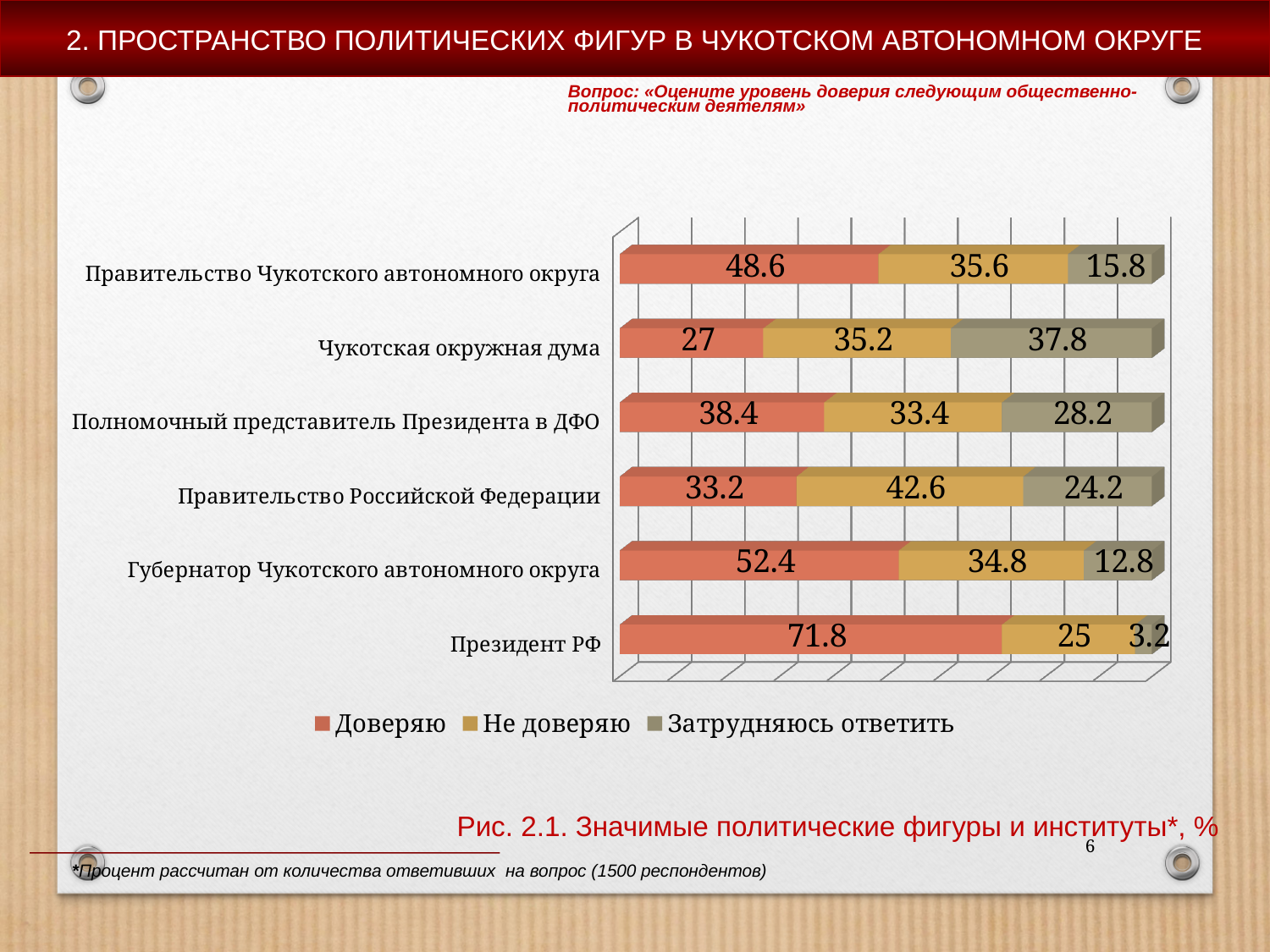
How many categories are shown in the chart? 6 Which has the larger «Не доверяю» value: «Правительство Российской Федерации» or «Полномочный представитель Президента в ДФО»? Правительство Российской Федерации What is the value of «Доверяю» for «Президент РФ»? 71.8 Which category has the lowest «Затрудняюсь ответить» value? Президент РФ How many series does the legend list? 3 Which category has the highest «Доверяю» value? Президент РФ What is the total of the stacked bar for «Президент РФ»? 100 Which category has the lowest «Доверяю» value? Чукотская окружная дума What is the value of «Затрудняюсь ответить» for «Чукотская окружная дума»? 37.8 What is the difference between the «Доверяю» values for «Губернатор Чукотского автономного округа» and «Правительство Чукотского автономного округа»? 3.8 What kind of chart is shown on the slide? Stacked bar chart What is the value of «Не доверяю» for «Правительство Российской Федерации»? 42.6